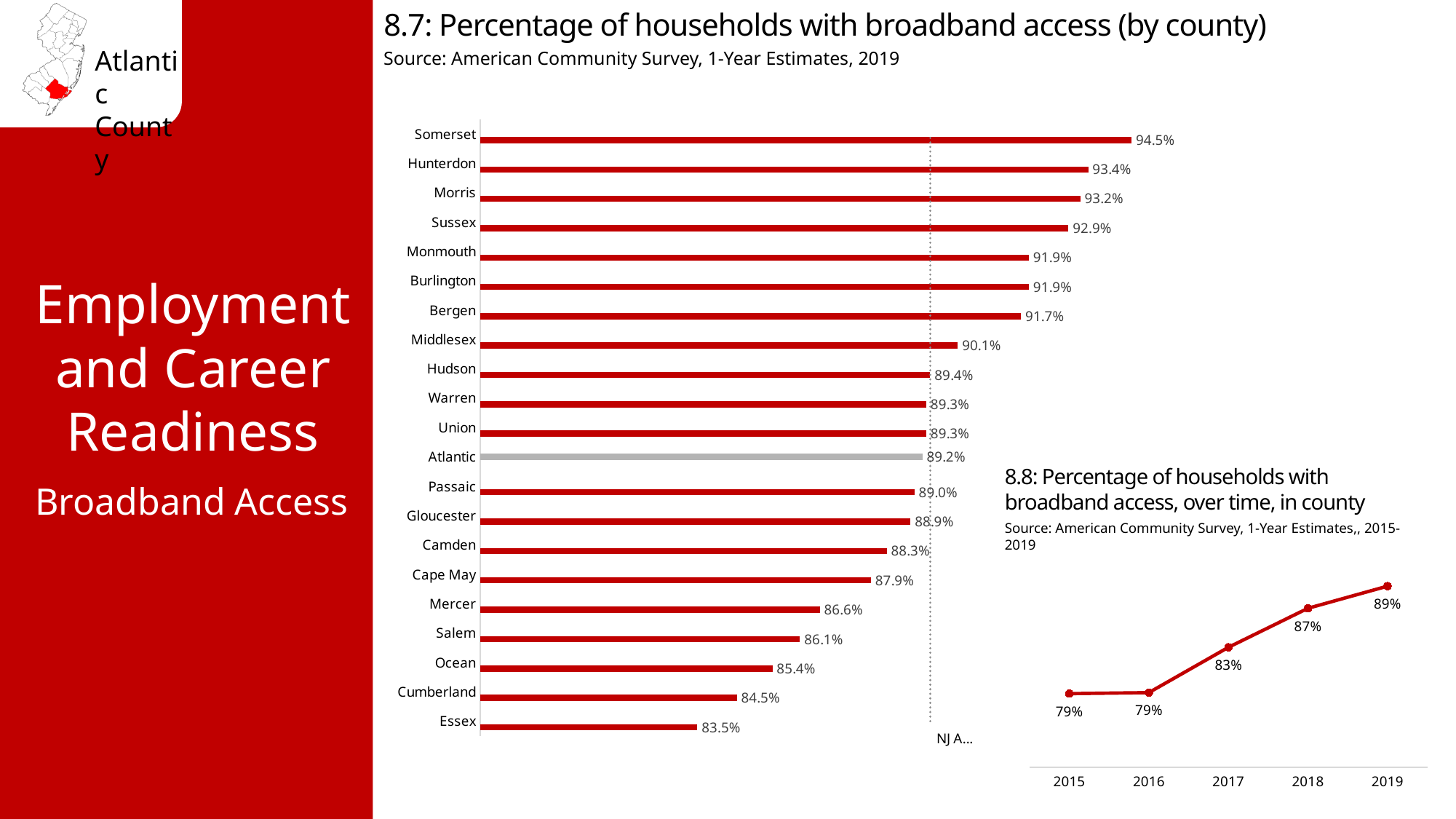
In chart 8.7 (by county), what is the difference between Somerset and Essex? 11.0% In chart 8.8 (broadband access over time in county), do values rise or fall from 2015 to 2019? Rise In chart 8.8 (broadband access over time in county), what is the difference between 2019 and 2015? 10% In chart 8.7 (by county), which has a higher value, Bergen or Middlesex? Bergen In chart 8.7 (by county), which county has the highest percentage of households with broadband access? Somerset In chart 8.7 (by county), which county has the lowest percentage of households with broadband access? Essex In chart 8.8 (broadband access over time in county), what is the value for 2017? 83% In chart 8.7 (Percentage of households with broadband access by county), what is the value for Atlantic? 89.2% What kind of chart is chart 8.7 (Percentage of households with broadband access by county)? Bar chart In chart 8.7 (by county), what is the value for Cumberland? 84.5% In chart 8.7 (by county), how many counties are shown? 21 In chart 8.7 (by county), which bar is coloured grey instead of red? Atlantic